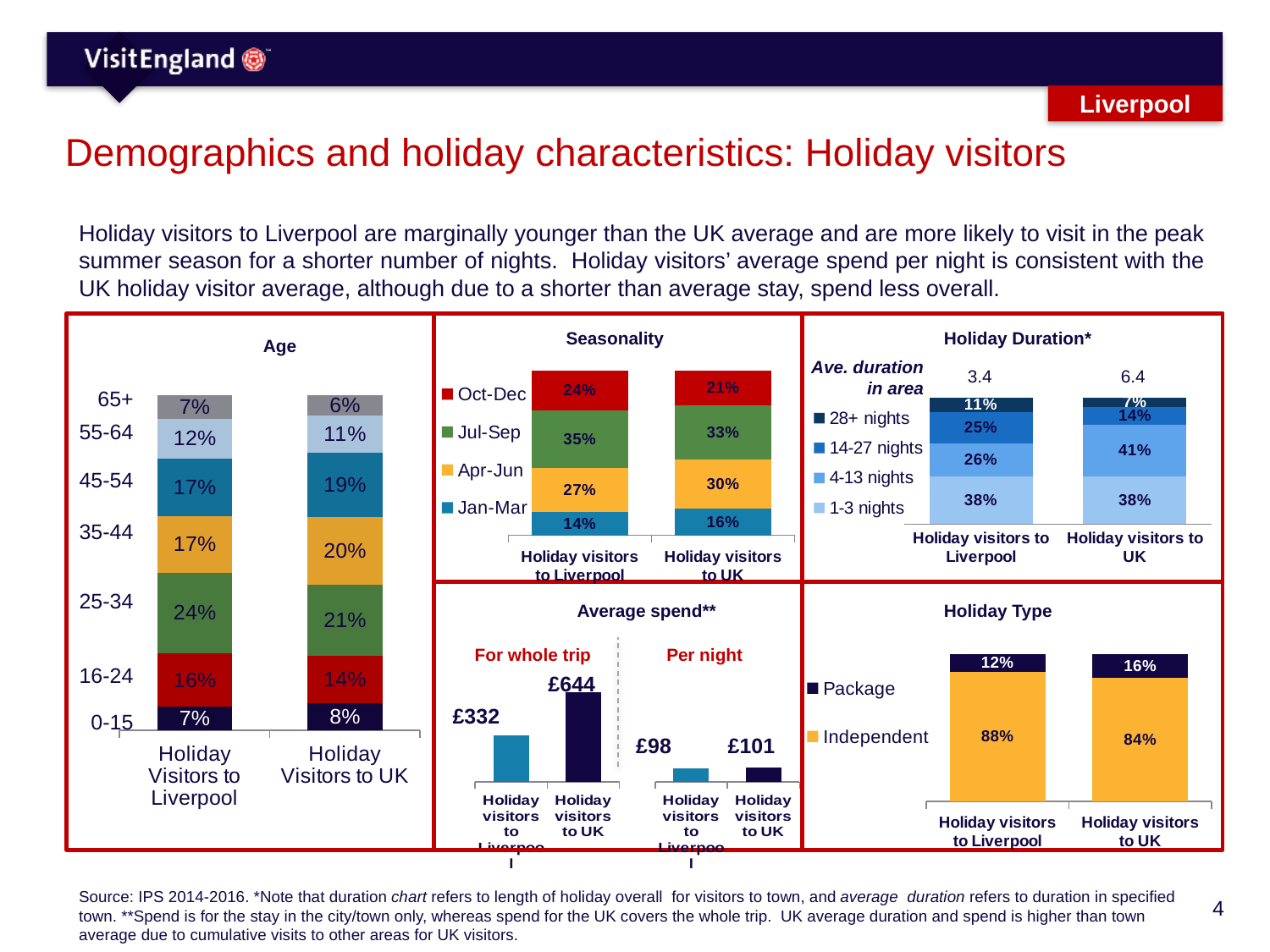
In the Holiday Duration chart, what percentage of holiday visitors to UK stay 4-13 nights? 41% In the Holiday Type chart, what percentage of holiday visitors to UK take a package holiday? 16% What kind of chart is the Holiday Type chart? Stacked bar chart In the Age chart, what percentage of holiday visitors to Liverpool are aged 25-34? 24% In the Seasonality chart, which quarter has the smallest share of holiday visitors to UK? Jan-Mar In the Age chart, which age group has the largest share of holiday visitors to UK? 25-34 In the Seasonality chart, what percentage of holiday visitors to Liverpool visit in Jul-Sep? 35% In the Age chart, what is the difference between the 35-44 share for holiday visitors to UK and for holiday visitors to Liverpool? 3% In the Average spend chart, what is the spend for the whole trip for holiday visitors to Liverpool? £332 In the Holiday Duration chart, what is the average duration in area for holiday visitors to Liverpool? 3.4 In the Average spend chart, which is larger: the per night spend for holiday visitors to Liverpool or for holiday visitors to UK? Holiday visitors to UK In the Seasonality chart, how many series does the legend list? 4